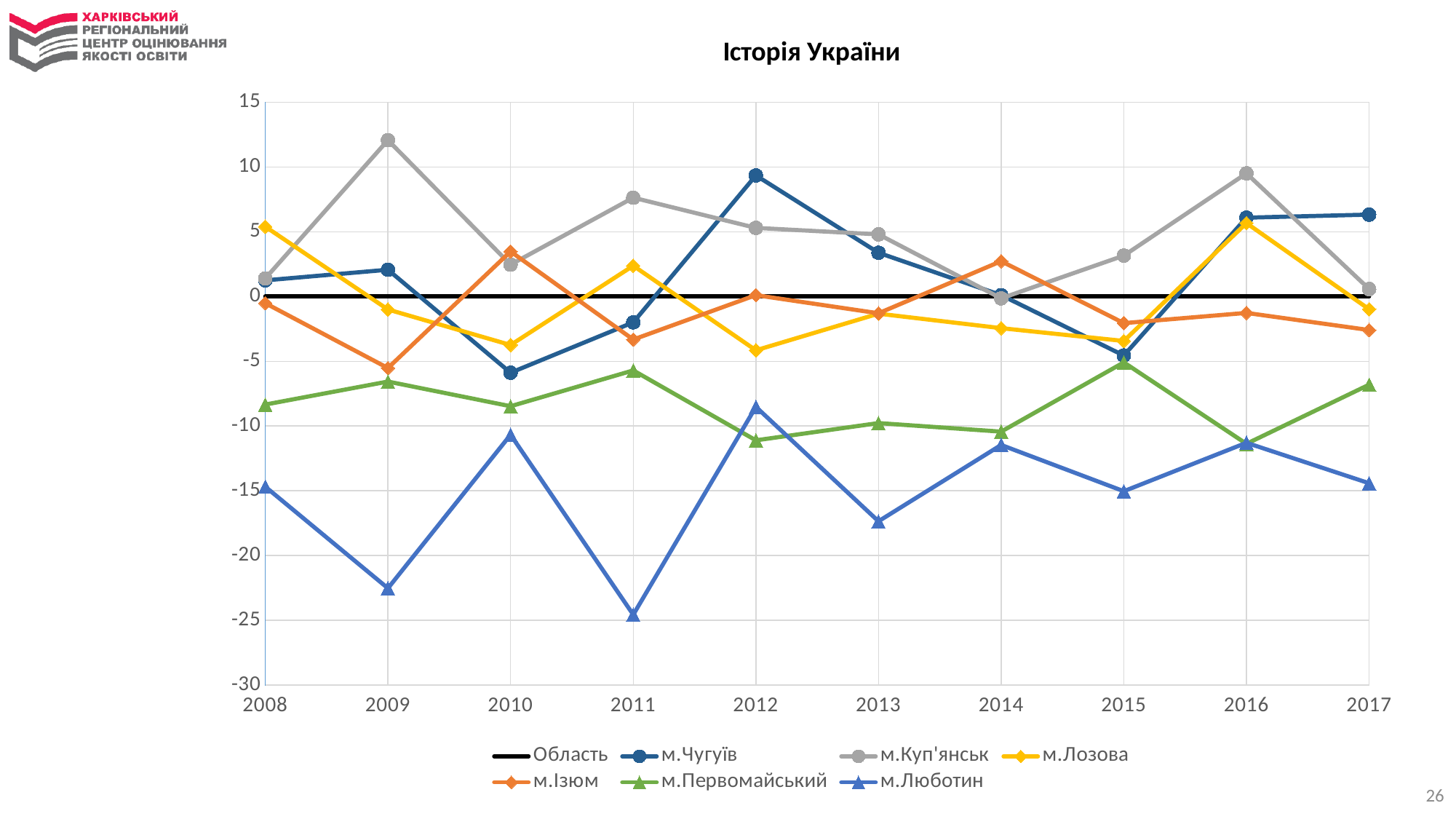
In which year does м.Люботин reach its lowest value? 2011 What kind of chart is shown on the slide? line chart How many years are plotted along the x axis? 10 Is the value for м.Люботин in 2011 greater or less than -20? less Is the value for м.Куп'янськ in 2009 greater or less than 10? greater What is the title of the chart? Історія України How many series does the legend list? 7 In 2012, which is higher: м.Чугуїв or м.Куп'янськ? м.Чугуїв In which year does м.Куп'янськ reach its highest value? 2009 Does the value for м.Чугуїв rise or fall from 2012 to 2015? fall Which series is drawn as the black line? Область Is the value for м.Чугуїв in 2012 greater or less than 5? greater